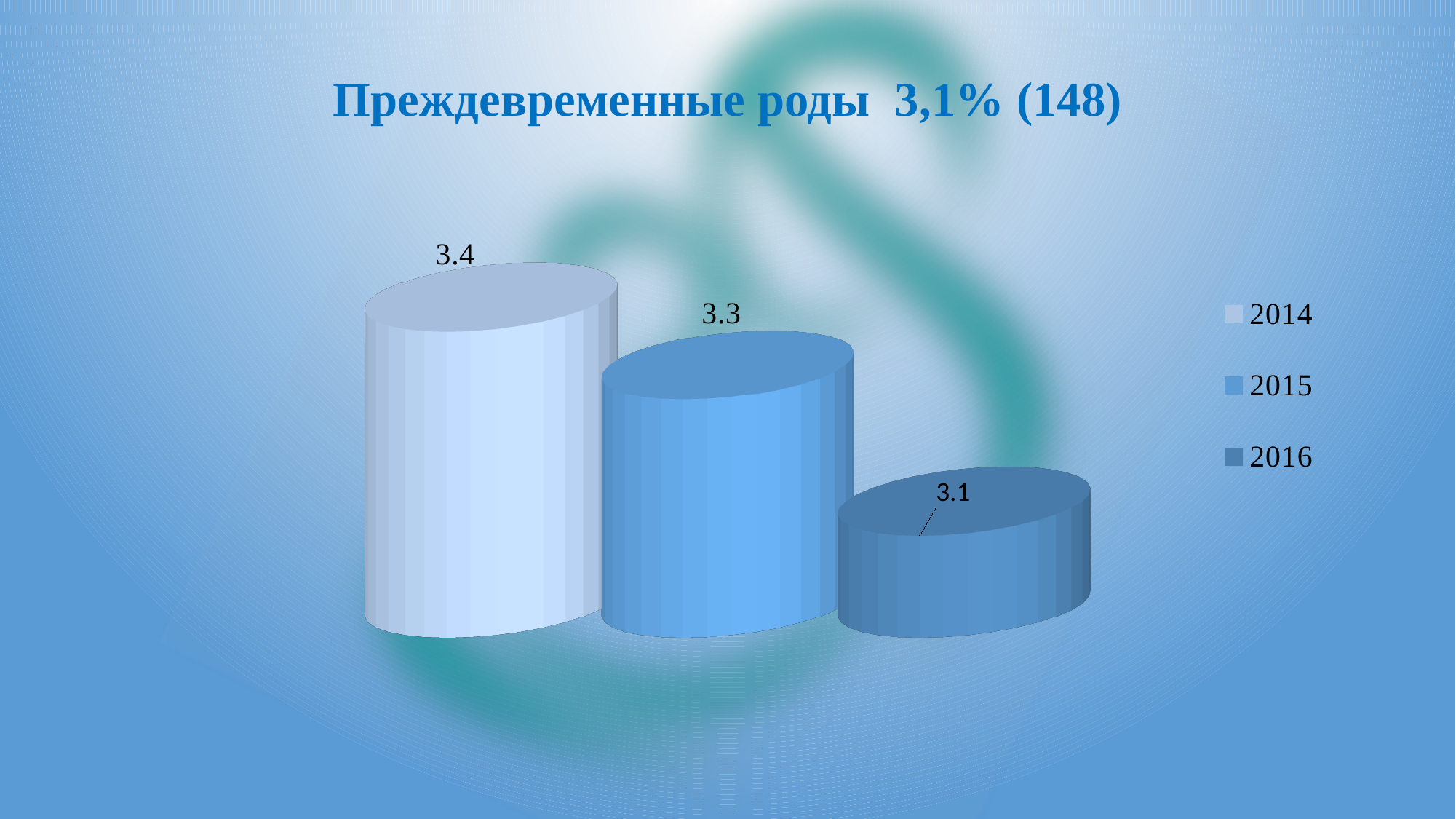
What kind of chart is shown on the slide? bar chart How many bars are plotted on the chart? 3 Do the values rise or fall from 2014 to 2016? fall Which year has the highest value? 2014 Which year has the lowest value? 2016 How many entries does the legend list? 3 What is the difference between the values for 2014 and 2016? 0.3 Which is larger, the value for 2014 or the value for 2015? 2014 What is the value for 2014? 3.4 What is the difference between the values for 2015 and 2016? 0.2 What is the value for 2016? 3.1 What is the value for 2015? 3.3